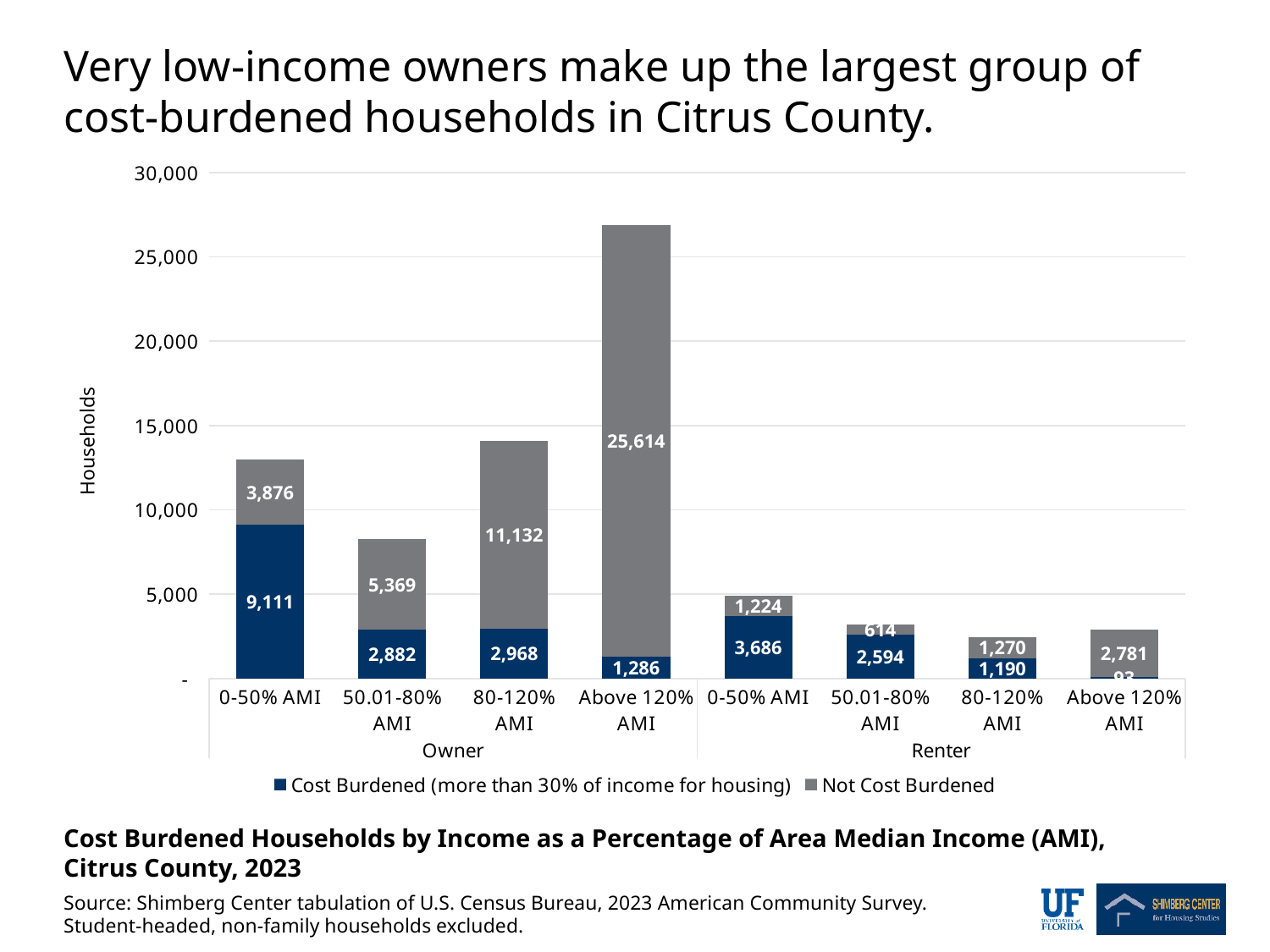
What is the total number of owner households in the 0-50% AMI group (cost burdened plus not cost burdened)? 12,987 Among owner groups, which has the smallest number of cost-burdened households? Above 120% AMI Which is larger: the number of not-cost-burdened owner households at 80-120% AMI or at 50.01-80% AMI? 80-120% AMI What kind of chart is shown on the slide? Stacked bar chart What is the difference between cost-burdened owner households in the 0-50% AMI group and cost-burdened renter households in the 0-50% AMI group? 5,425 Is the total number of owner households in the Above 120% AMI group greater or less than 25,000? greater How many series does the legend list? 2 How many income categories are shown on the x axis in total across owners and renters? 8 How many not-cost-burdened owner households are in the Above 120% AMI group? 25,614 Which income group has the largest number of cost-burdened households? Owner 0-50% AMI How many cost-burdened owner households are in the 0-50% AMI group? 9,111 How many cost-burdened renter households are in the 50.01-80% AMI group? 2,594